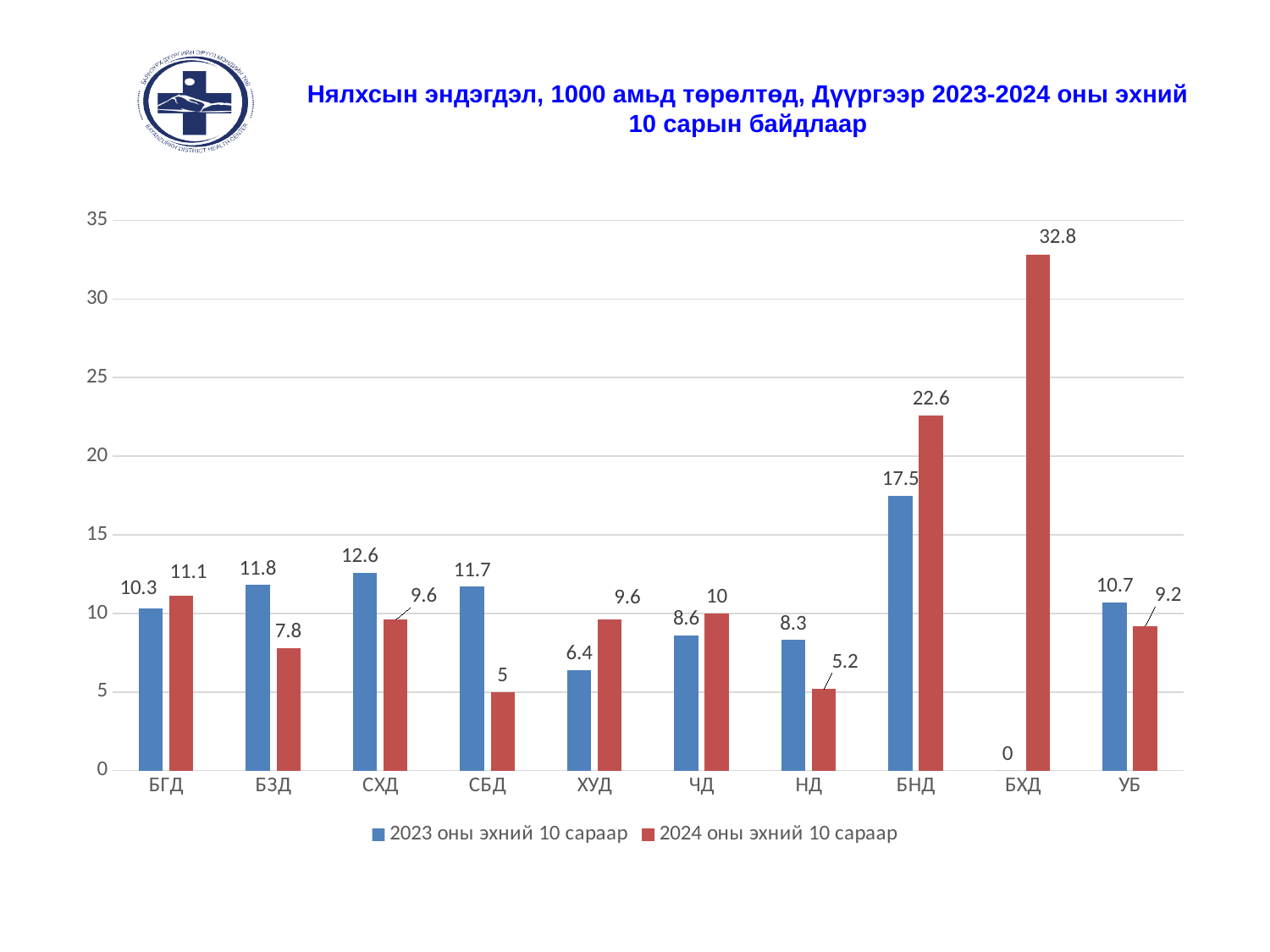
What is the value for СХД in the 2023 оны эхний 10 сараар series? 12.6 How many series does the legend list? 2 Is the value for БХД in the 2024 оны эхний 10 сараар series greater or less than 30? greater What is the difference between the 2024 and 2023 values for БНД? 5.1 Which category has the highest value in the 2024 оны эхний 10 сараар series? БХД What colour are the bars for the 2024 оны эхний 10 сараар series? red Which is larger for СБД: the 2023 оны эхний 10 сараар value or the 2024 оны эхний 10 сараар value? 2023 оны эхний 10 сараар Which category has the lowest value in the 2023 оны эхний 10 сараар series? БХД What is the value for БНД in the 2024 оны эхний 10 сараар series? 22.6 What kind of chart is shown on the slide? bar chart What is the value for БХД in the 2023 оны эхний 10 сараар series? 0 How many categories are shown on the x axis? 10